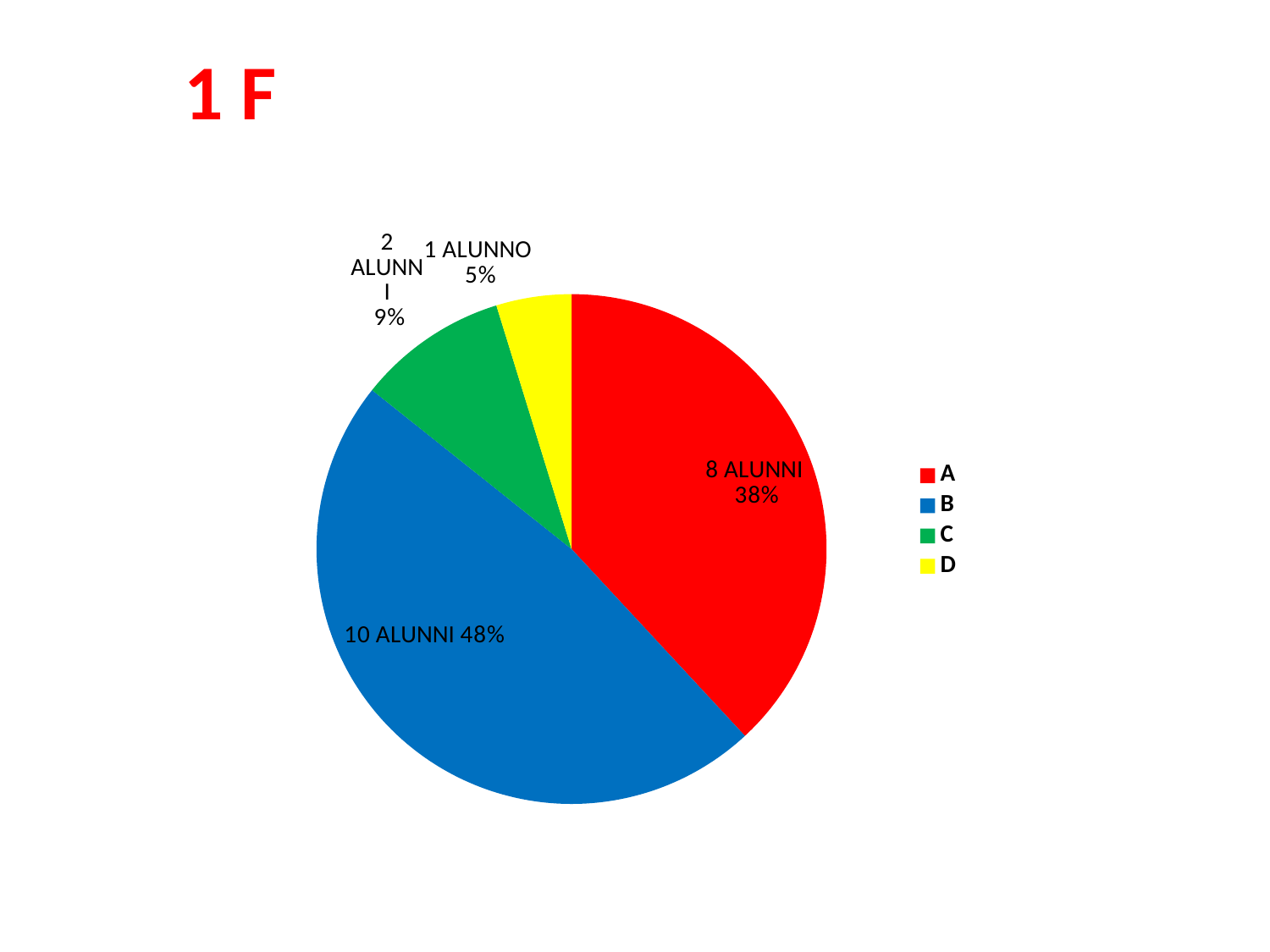
What is the difference in percentage points between slice B and slice A? 10 Which category has the largest slice? B What percentage share does slice B have? 48% What percentage share does slice A have? 38% What percentage share does slice D have? 5% How many alunni are in category A? 8 ALUNNI What kind of chart is shown on the slide? pie chart What colour is slice C? green Which category has the smallest slice? D How many categories does the legend list? 4 How many alunni are in category B? 10 ALUNNI